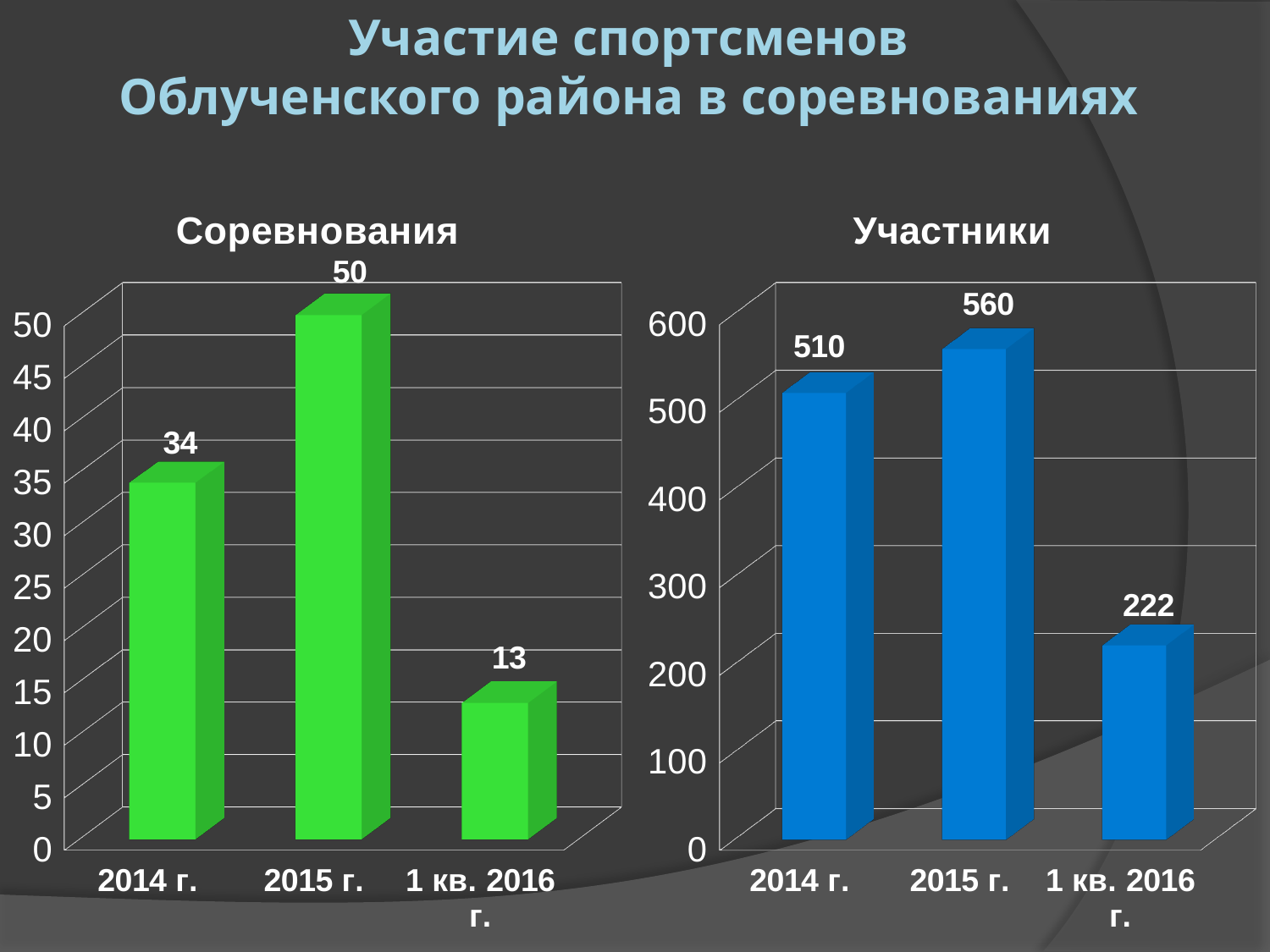
In the "Участники" chart, what is the value for 2014 г.? 510 What kind of chart is the "Соревнования" chart? bar chart In the "Участники" chart, what is the value for 1 кв. 2016 г.? 222 How many categories are shown in the "Участники" chart? 3 In the "Участники" chart, what is the difference between the values for 2015 г. and 1 кв. 2016 г.? 338 In the "Участники" chart, which category has the highest value? 2015 г. In the "Соревнования" chart, which category has the lowest value? 1 кв. 2016 г. In the "Соревнования" chart, is the value for 2014 г. greater or less than 30? greater In the "Соревнования" chart, what is the value for 2015 г.? 50 In the "Участники" chart, which is larger, the value for 2014 г. or the value for 2015 г.? 2015 г. What colour are the bars in the "Соревнования" chart? green In the "Соревнования" chart, what is the difference between the values for 2015 г. and 2014 г.? 16